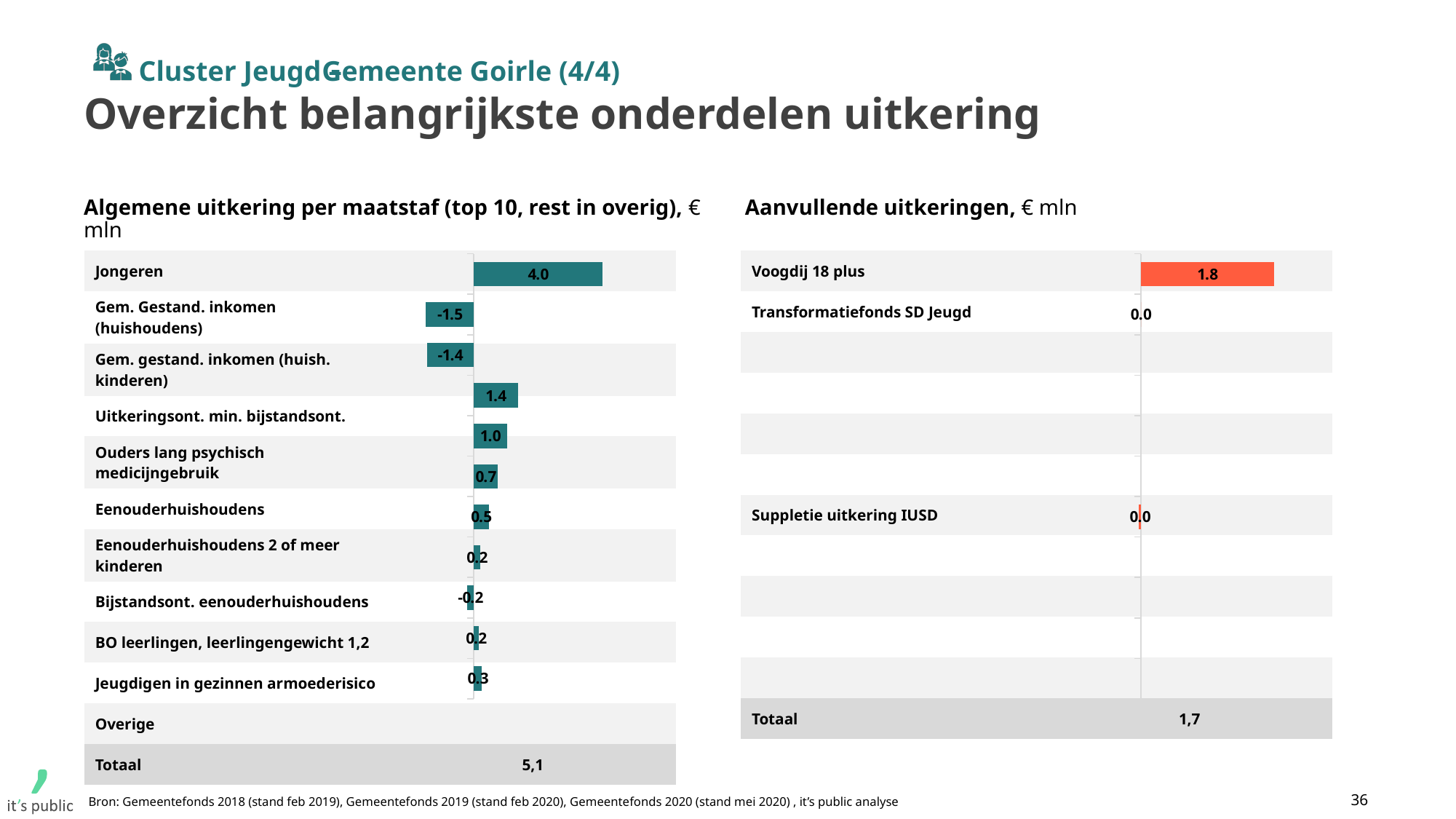
In the chart 'Aanvullende uitkeringen', what is the value for Transformatiefonds SD Jeugd? 0.0 In the chart 'Algemene uitkering per maatstaf', which category has the lowest value? Gem. Gestand. inkomen (huishoudens) In the chart 'Algemene uitkering per maatstaf', what is the Totaal shown? 5,1 In the chart 'Algemene uitkering per maatstaf', what is the value for Gem. Gestand. inkomen (huishoudens)? -1.5 What unit is stated in the title of the chart 'Aanvullende uitkeringen'? € mln Which is larger: Jongeren in the left chart or Voogdij 18 plus in the right chart? Jongeren What kind of chart is used for 'Algemene uitkering per maatstaf'? Bar chart In the chart 'Aanvullende uitkeringen', what is the Totaal shown? 1,7 In the chart 'Algemene uitkering per maatstaf', which category has the highest value? Jongeren What is the difference between the value for Jongeren in the left chart and the value for Voogdij 18 plus in the right chart? 2.2 In the chart 'Algemene uitkering per maatstaf', what is the value for Jongeren? 4.0 In the chart 'Aanvullende uitkeringen', what is the value for Voogdij 18 plus? 1.8